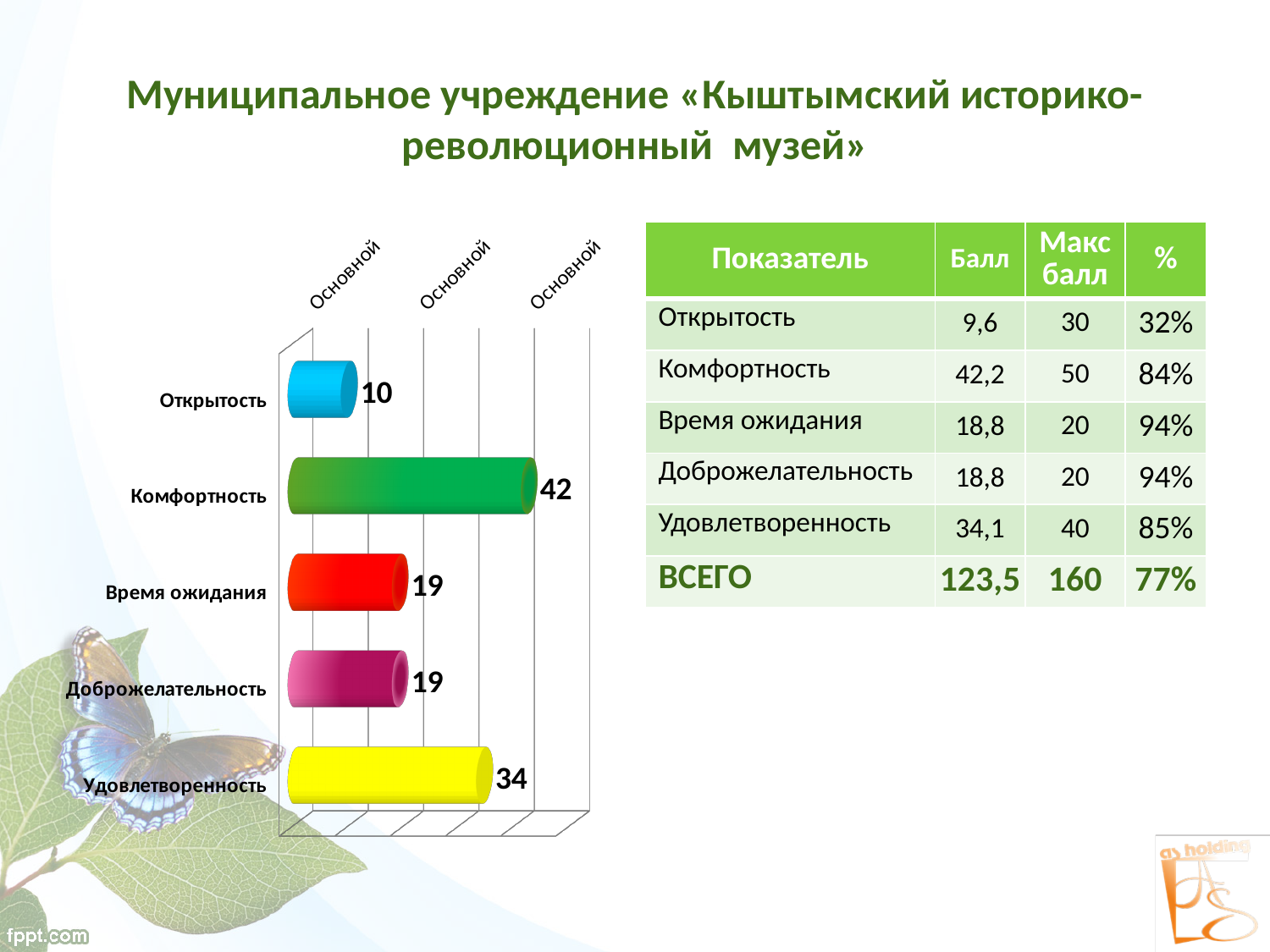
What is the value for Комфортность in the bar chart? 42 What is the difference between the values for Комфортность and Удовлетворенность in the bar chart? 8 What is the difference between the values for Доброжелательность and Открытость in the bar chart? 9 What kind of chart is shown on the slide? Bar chart What is the value for Удовлетворенность in the bar chart? 34 What colour is the bar for Удовлетворенность in the bar chart? Yellow Which category has the highest value in the bar chart? Комфортность How many categories are shown in the bar chart? 5 Which is larger in the bar chart, the value for Удовлетворенность or the value for Время ожидания? Удовлетворенность What is the value for Время ожидания in the bar chart? 19 What is the value for Открытость in the bar chart? 10 Which category has the lowest value in the bar chart? Открытость